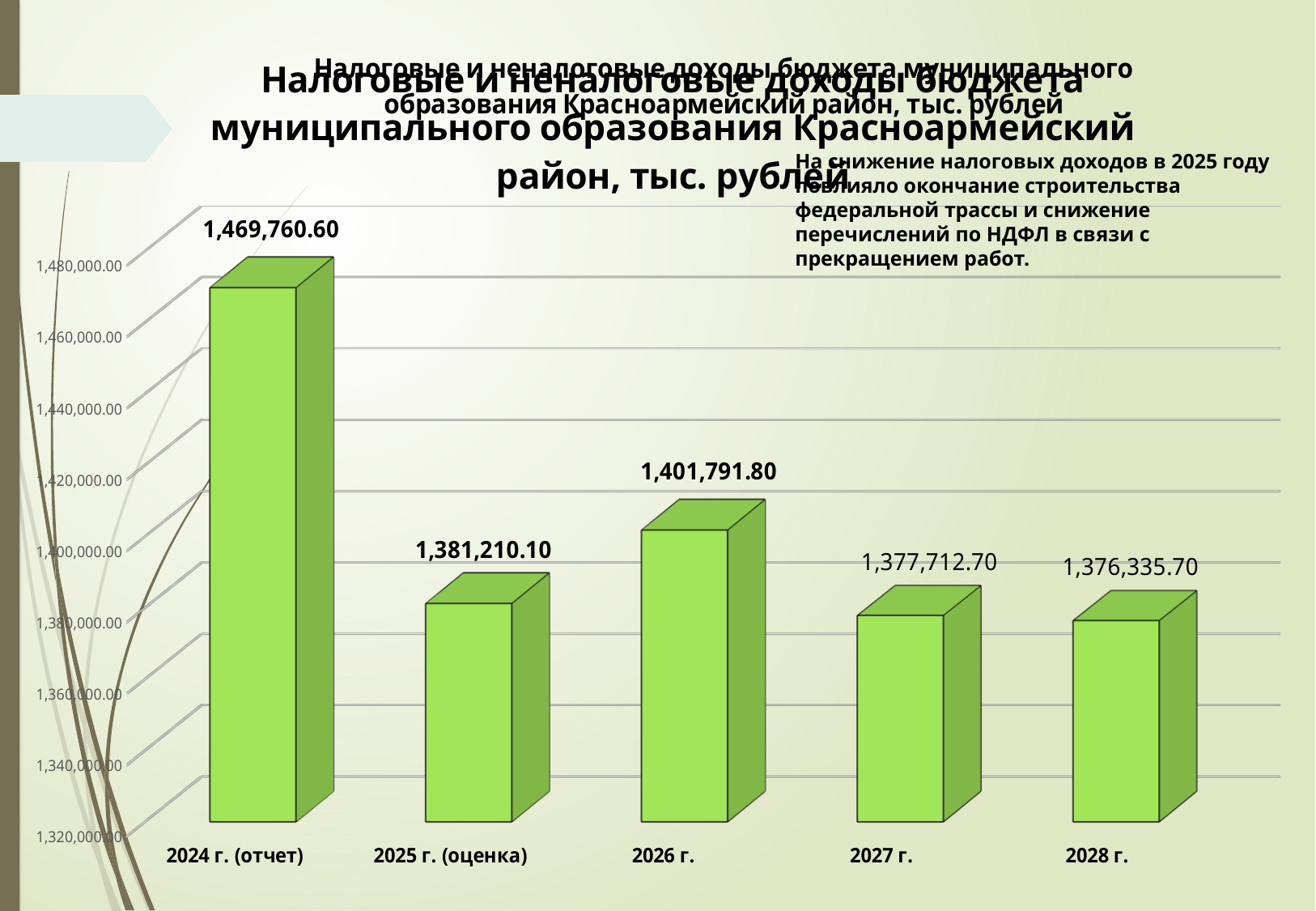
What is the value for 2025 г. (оценка)? 1,381,210.10 What is the difference between the values for 2026 г. and 2027 г.? 24,079.10 What is the value for 2024 г. (отчет)? 1,469,760.60 Which is larger, the value for 2026 г. or the value for 2025 г. (оценка)? 2026 г. Which year has the lowest value? 2028 г. Which year has the highest value? 2024 г. (отчет) Is the value for 2025 г. (оценка) greater or less than 1,400,000.00? less What is the difference between the values for 2024 г. (отчет) and 2025 г. (оценка)? 88,550.50 How many years are shown on the chart? 5 What is the value for 2026 г.? 1,401,791.80 What kind of chart is shown on the slide? bar chart What is the value for 2028 г.? 1,376,335.70